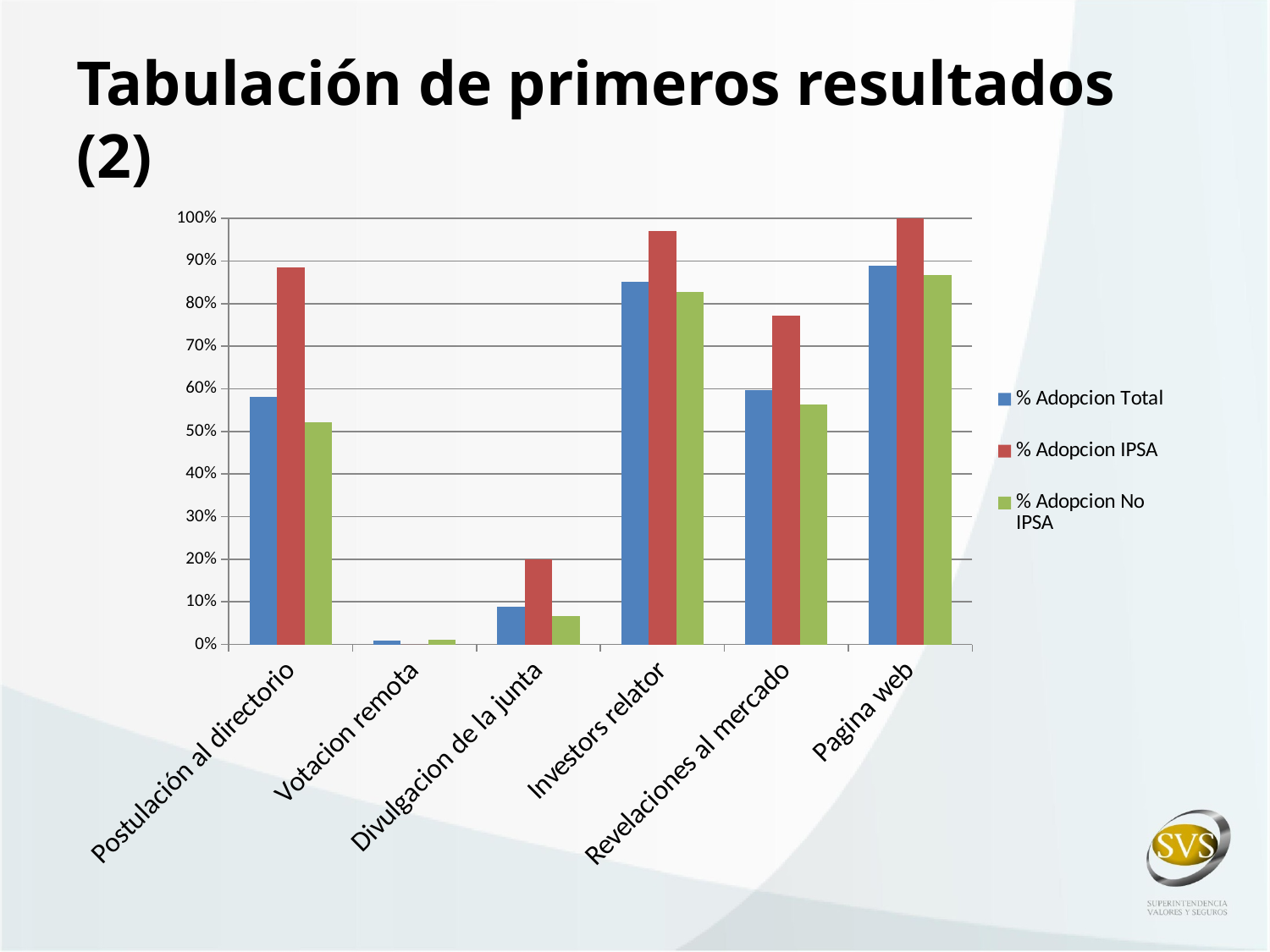
Is the value of % Adopcion IPSA for Revelaciones al mercado greater or less than 70%? greater What kind of chart is shown on the slide? bar chart Which category has a higher % Adopcion Total: Revelaciones al mercado or Pagina web? Pagina web What is the value of % Adopcion IPSA for Pagina web? 100% Which category has the highest value for % Adopcion IPSA? Pagina web Is the value of % Adopcion No IPSA for Divulgacion de la junta greater or less than 10%? less Which colour represents % Adopcion No IPSA in the legend? green How many categories are shown on the x axis? 6 Which category has the lowest value for % Adopcion Total? Votacion remota How many series does the legend list? 3 Is the value of % Adopcion Total for Postulación al directorio greater or less than 50%? greater For Investors relator, which is larger: % Adopcion IPSA or % Adopcion No IPSA? % Adopcion IPSA